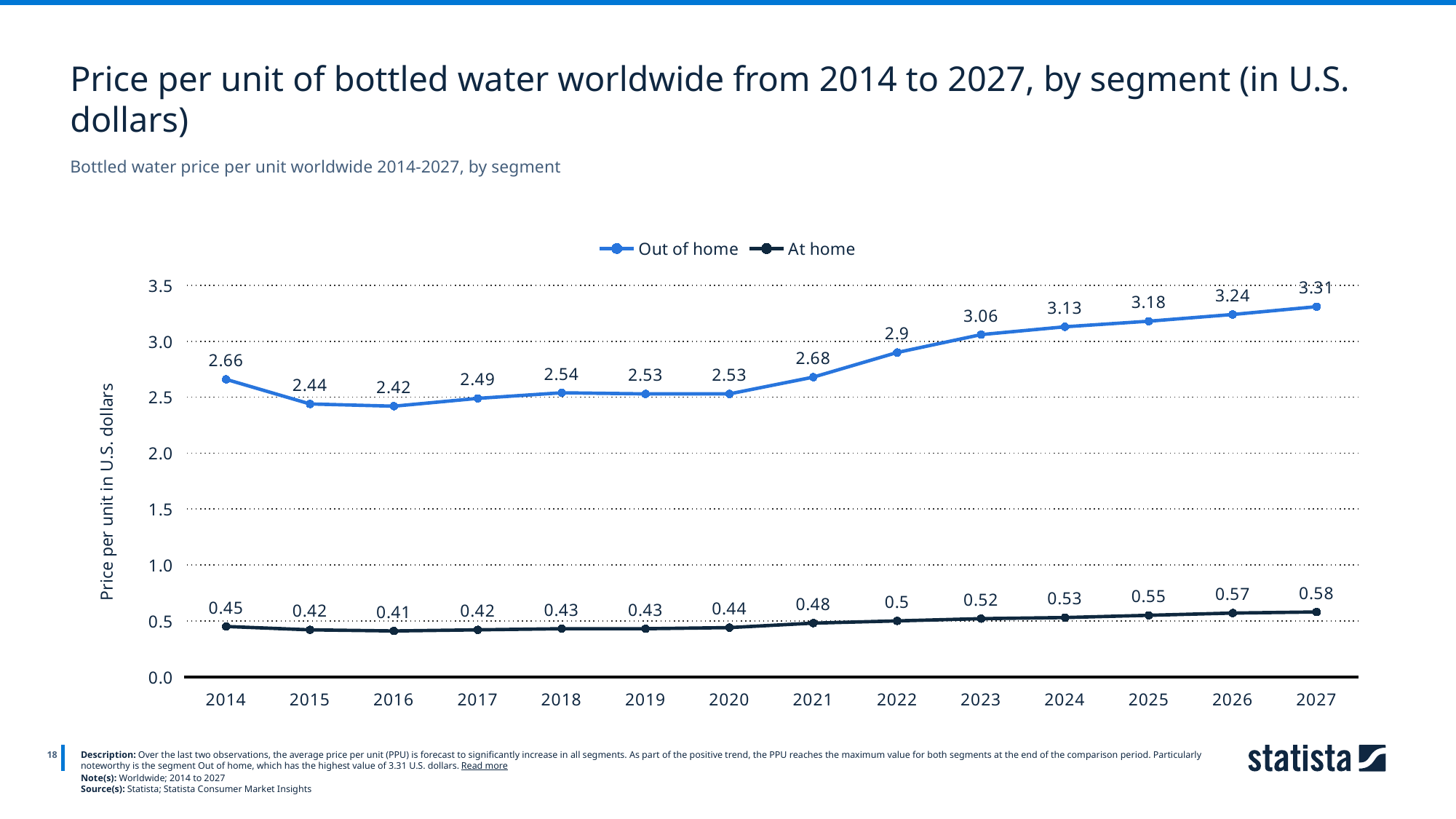
Is the Out of home price per unit in 2023 greater or less than 3.0? greater What is the Out of home price per unit in 2022? 2.9 How many years are shown on the x axis? 14 How many series does the legend list? 2 What is the At home price per unit in 2027? 0.58 In which year is the At home price per unit lowest? 2016 Which is larger, the Out of home price in 2016 or in 2017? 2017 In which year is the Out of home price per unit highest? 2027 What is the difference between the Out of home and At home price per unit in 2027? 2.73 What kind of chart is shown on the slide? Line chart What is the Out of home price per unit in 2014? 2.66 Does the At home price per unit rise or fall from 2021 to 2027? Rise